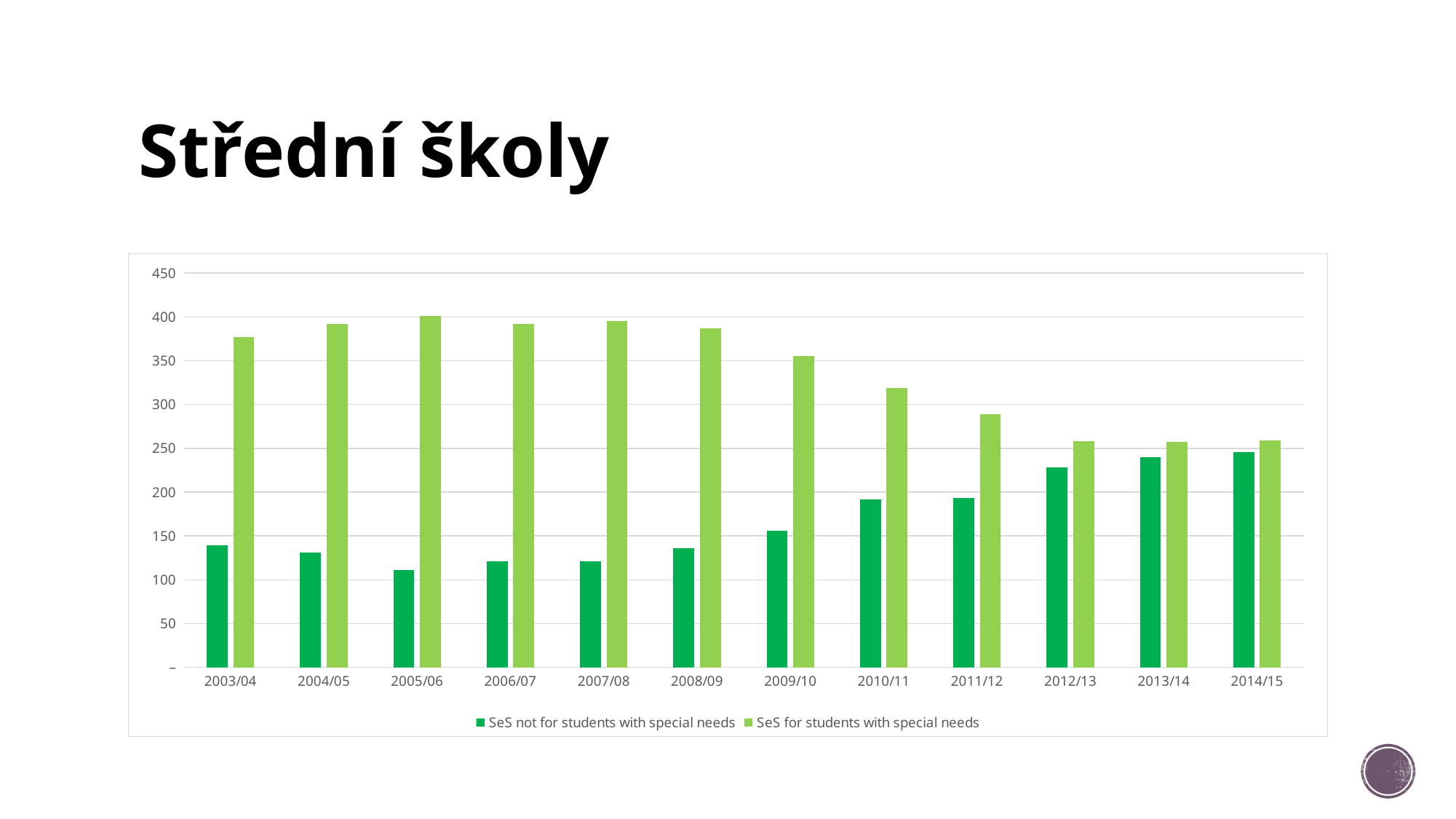
In 2003/04, which series has the larger value: 'SeS for students with special needs' or 'SeS not for students with special needs'? SeS for students with special needs What is the title of the slide containing the chart? Střední školy For 'SeS not for students with special needs', which is larger: the value in 2003/04 or the value in 2014/15? 2014/15 Is the value for 'SeS for students with special needs' in 2011/12 greater or less than 300? less Do the values for 'SeS for students with special needs' generally rise or fall from 2005/06 to 2014/15? fall Is the value for 'SeS not for students with special needs' in 2012/13 greater or less than 200? greater How many series does the chart's legend list? 2 How many school years are shown on the x axis of the chart? 12 Is the value for 'SeS for students with special needs' in 2003/04 greater or less than 350? greater Which school year has the lowest value for 'SeS not for students with special needs'? 2005/06 What kind of chart is shown on the slide? bar chart